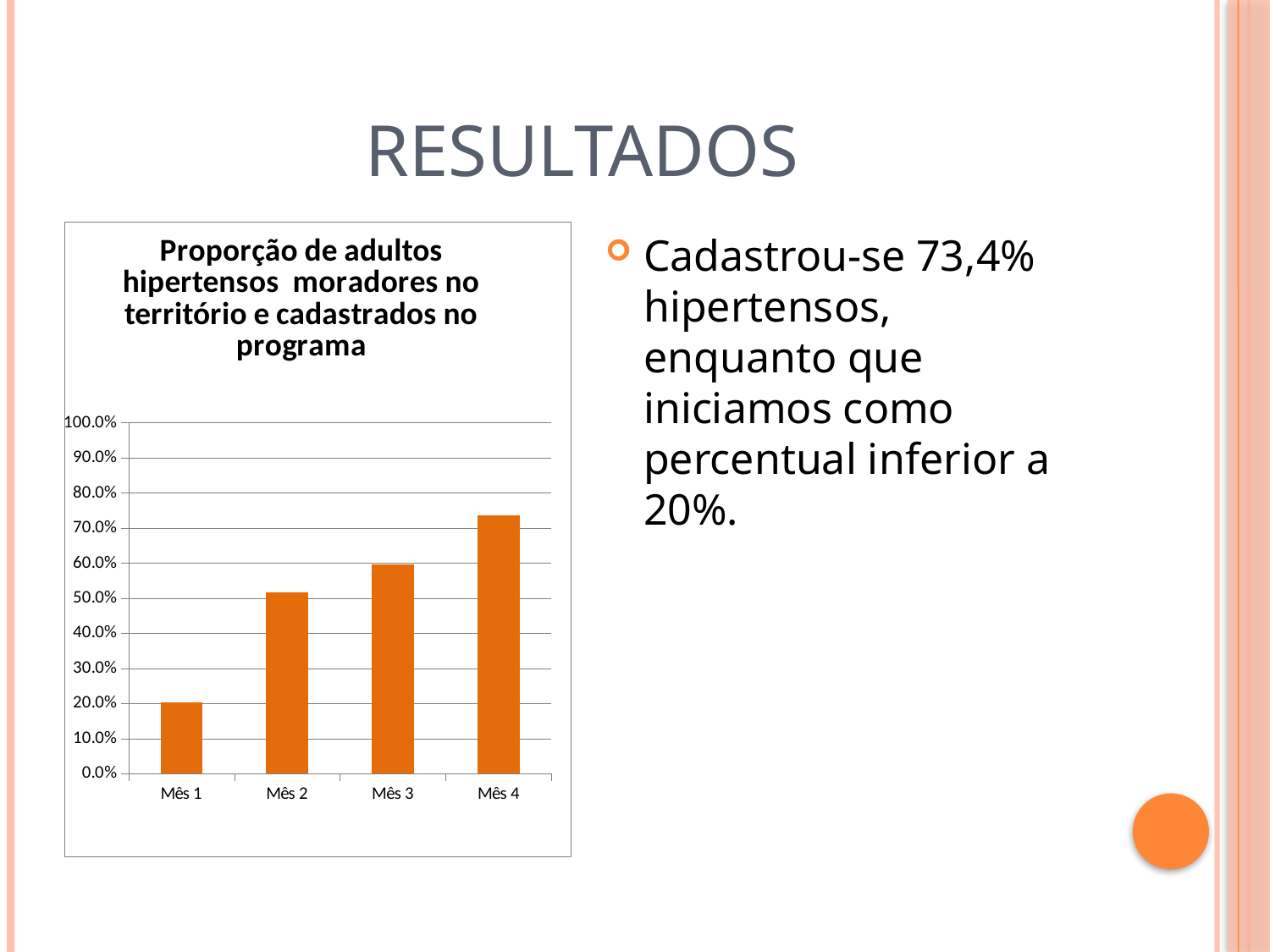
Is the value for Mês 4 greater or less than 80.0%? less Is the value for Mês 3 greater or less than 70.0%? less Is the value for Mês 4 greater or less than 70.0%? greater Which month has the highest bar? Mês 4 How many categories (months) are plotted on the x axis? 4 Which month has the lowest bar? Mês 1 Which is larger, the value for Mês 2 or the value for Mês 4? Mês 4 What kind of chart is shown on the slide? bar chart Do the values rise or fall from Mês 1 to Mês 4? rise What is the title of the chart? Proporção de adultos hipertensos moradores no território e cadastrados no programa